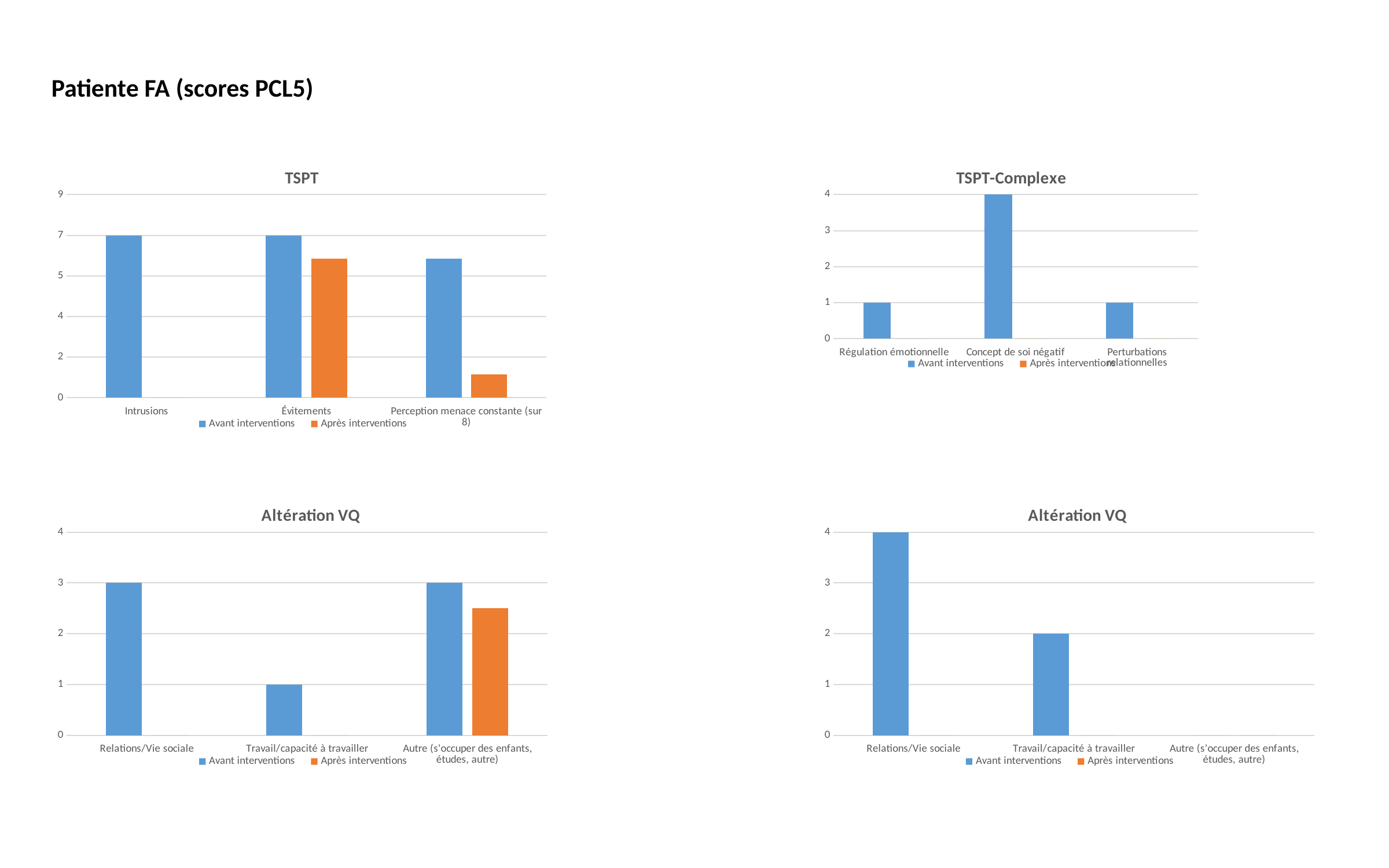
How many series does the legend of the TSPT chart list? 2 In the bottom-left Altération VQ chart, what is the Avant interventions value for Travail/capacité à travailler? 1 In the TSPT chart, is the Après interventions value for Perception menace constante greater or less than 2? less In the bottom-right Altération VQ chart, what is the Avant interventions value for Travail/capacité à travailler? 2 How many categories are shown on the x axis of the TSPT-Complexe chart? 3 In the bottom-left Altération VQ chart, which category has the lowest Avant interventions value? Travail/capacité à travailler In the TSPT chart, is the Avant interventions value for Intrusions greater or less than 5? greater In the bottom-right Altération VQ chart, what is the difference between the Avant interventions values for Relations/Vie sociale and Travail/capacité à travailler? 2 In the TSPT-Complexe chart, which category has the highest Avant interventions value? Concept de soi négatif In the bottom-right Altération VQ chart, what is the Avant interventions value for Relations/Vie sociale? 4 In the bottom-left Altération VQ chart, what is the Avant interventions value for Relations/Vie sociale? 3